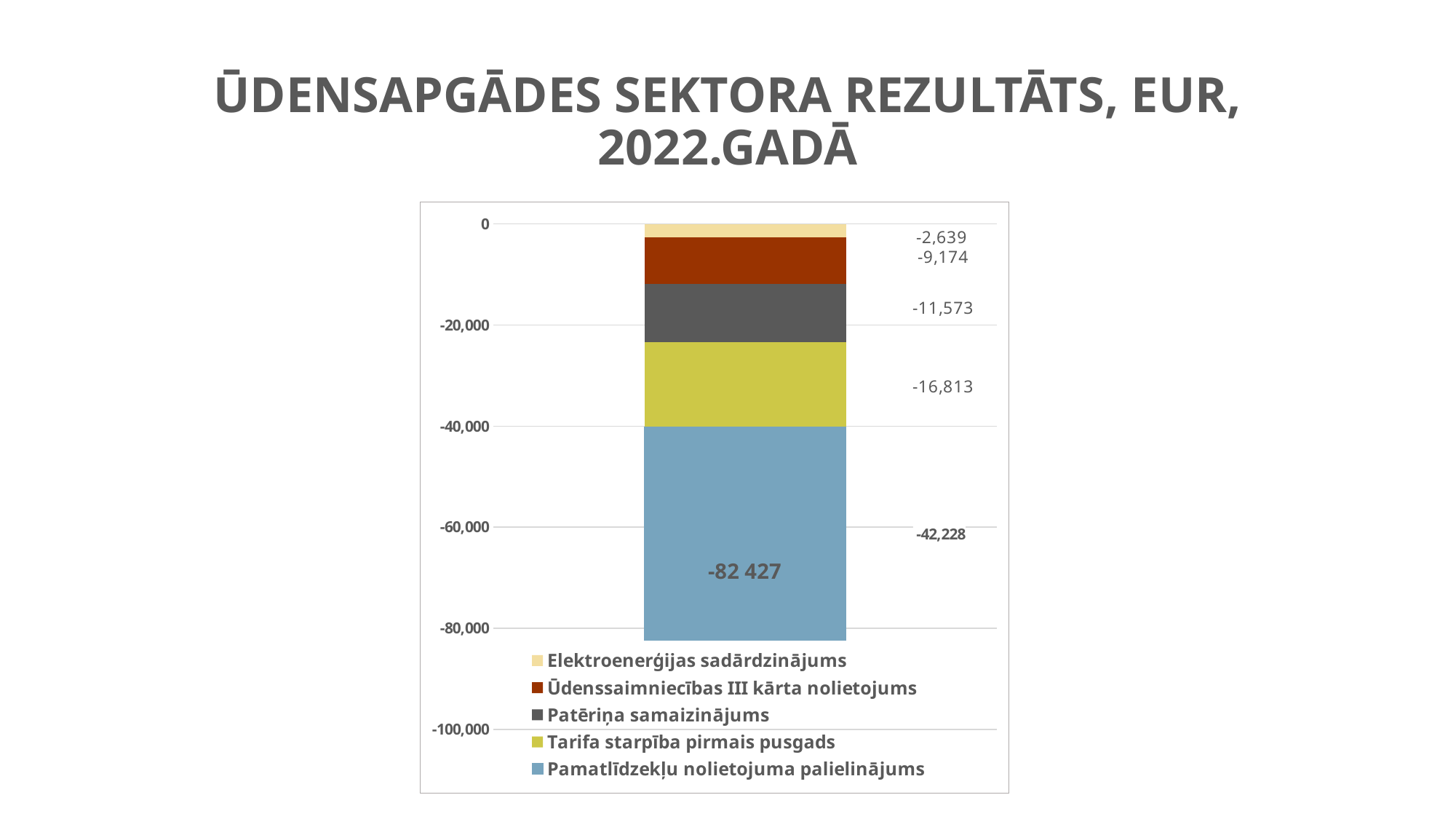
What is the value for Elektroenerģijas sadārdzinājums? -2,639 What is the total of the stacked bar? -82 427 What is the title of the chart? ŪDENSAPGĀDES SEKTORA REZULTĀTS, EUR, 2022.GADĀ How many series does the legend list? 5 Which series has the smallest magnitude in the stacked bar? Elektroenerģijas sadārdzinājums Which series has the largest magnitude in the stacked bar? Pamatlīdzekļu nolietojuma palielinājums What kind of chart is shown on the slide? stacked bar chart What is the value for Tarifa starpība pirmais pusgads? -16,813 What is the value for Ūdenssaimniecības III kārta nolietojums? -9,174 What is the difference between the values for Tarifa starpība pirmais pusgads and Patēriņa samaizinājums? 5,240 What is the value for Patēriņa samaizinājums? -11,573 What is the value for Pamatlīdzekļu nolietojuma palielinājums? -42,228